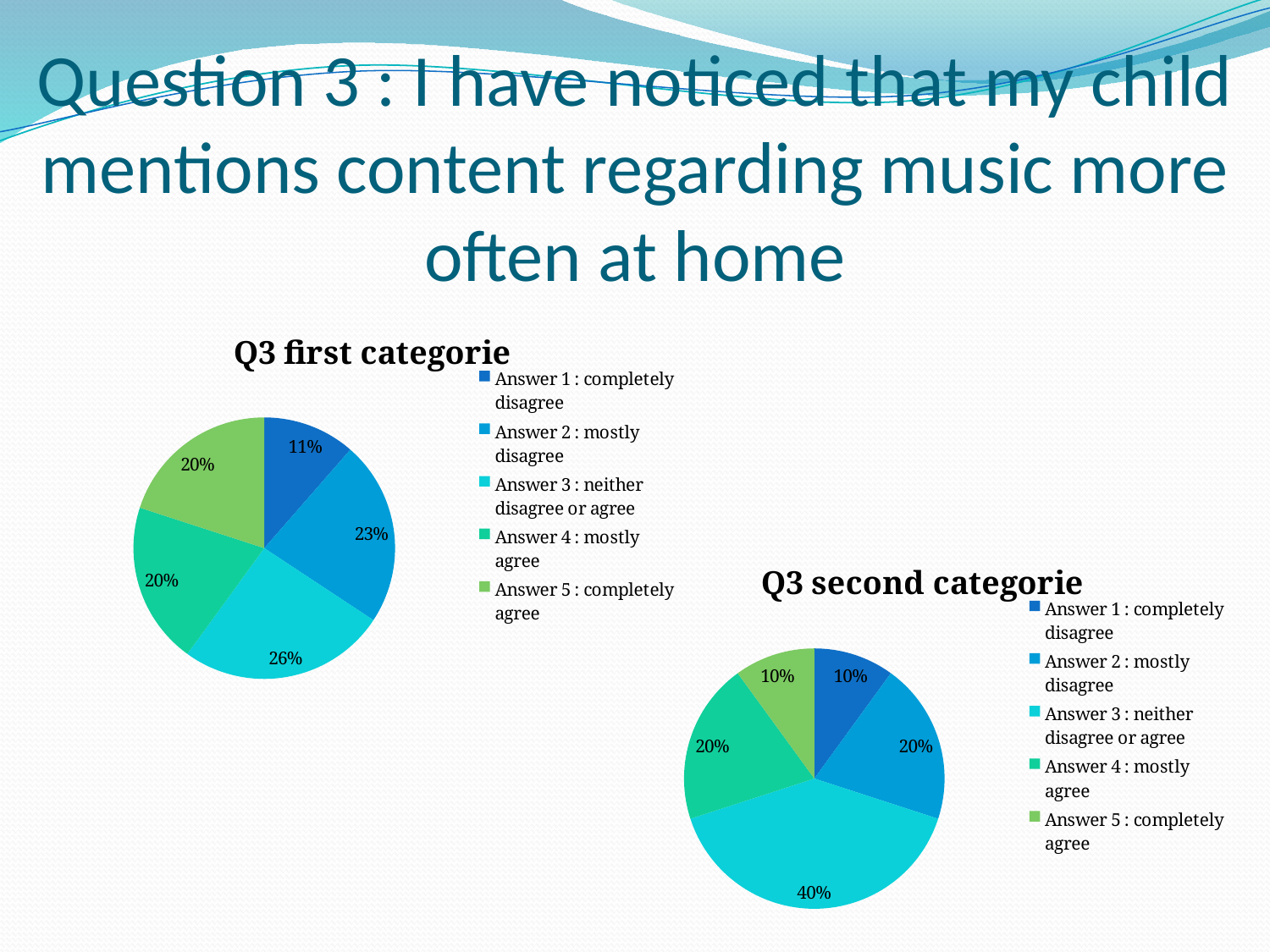
In the 'Q3 second categorie' chart, which answer has the largest slice? Answer 3 : neither disagree or agree How many slices does the 'Q3 second categorie' chart have? 5 In the 'Q3 second categorie' chart, what share is labelled for Answer 5 : completely agree? 10% In the 'Q3 second categorie' chart, what share is labelled for Answer 3 : neither disagree or agree? 40% In the 'Q3 second categorie' chart, is the slice for Answer 3 : neither disagree or agree larger or smaller than the slice for Answer 2 : mostly disagree? larger In the 'Q3 first categorie' chart, what is the difference between the shares for Answer 2 : mostly disagree and Answer 1 : completely disagree? 12% What type of chart is 'Q3 first categorie'? pie chart In the 'Q3 first categorie' chart, what share is labelled for Answer 3 : neither disagree or agree? 26% In the 'Q3 first categorie' chart, which answer has the largest slice? Answer 3 : neither disagree or agree How many entries does the legend of the 'Q3 first categorie' chart list? 5 In the 'Q3 first categorie' chart, which answer has the smallest slice? Answer 1 : completely disagree